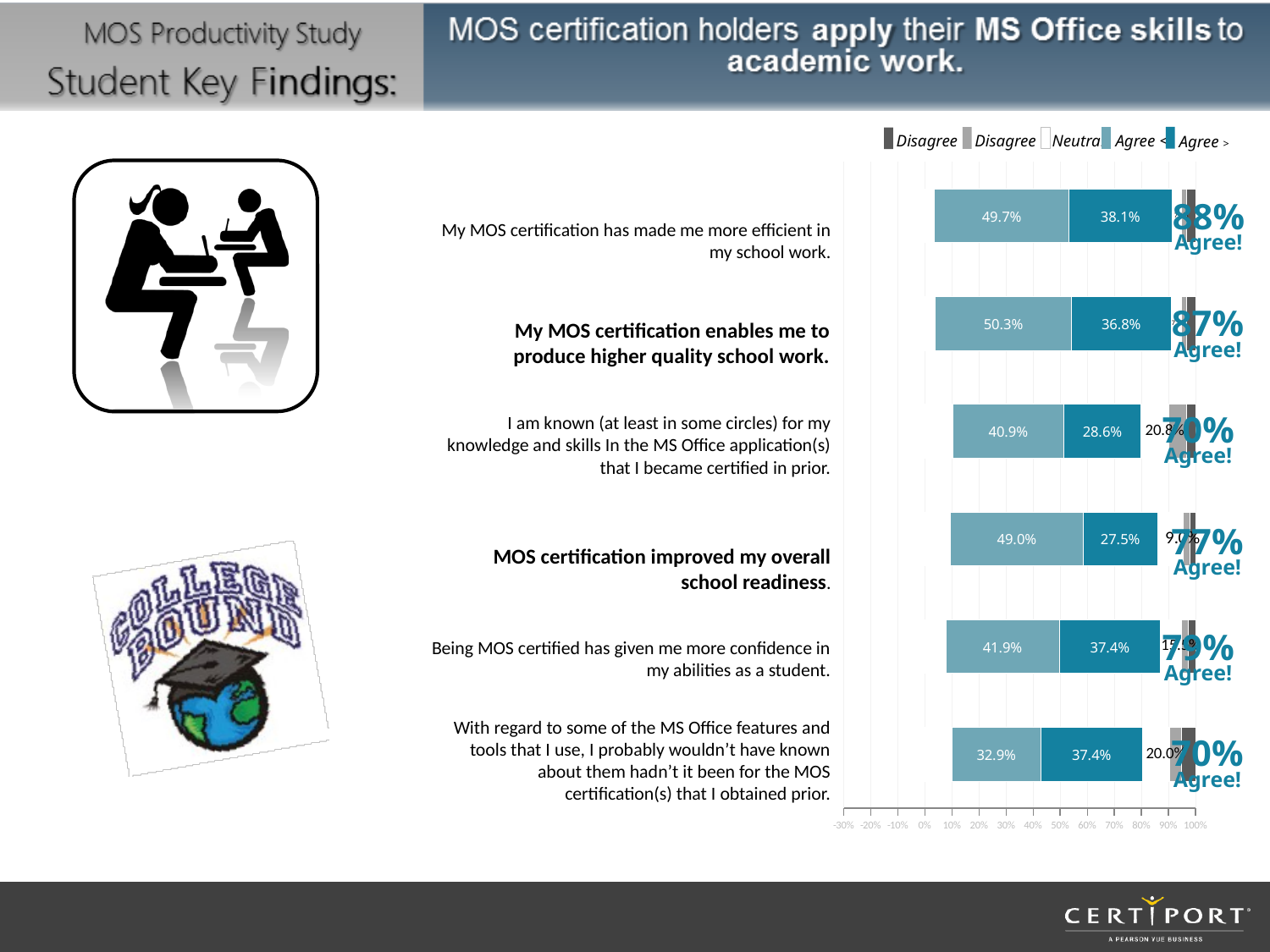
How many statements (categories) are plotted in the chart? 6 What overall agreement percentage is printed next to the bar for 'MOS certification improved my overall school readiness'? 77% What neutral value is labelled for 'I am known (at least in some circles) for my knowledge and skills in the MS Office application(s) that I became certified in prior'? 20.8% What overall agreement percentage is printed next to the bar for 'Being MOS certified has given me more confidence in my abilities as a student'? 79% How many series does the chart legend list? 5 For 'My MOS certification has made me more efficient in my school work', what is the difference between the lighter teal segment (49.7%) and the darker teal segment (38.1%)? 11.6 percentage points Which statement has the lowest value in the lighter teal segment? With regard to some of the MS Office features and tools that I use, I probably wouldn't have known about them hadn't it been for the MOS certification(s) that I obtained prior. Which statement has the highest value in the lighter teal segment? My MOS certification enables me to produce higher quality school work. What type of chart is shown on the slide? Stacked horizontal bar chart What is the value of the darker teal segment for 'My MOS certification enables me to produce higher quality school work'? 36.8% What is the value of the lighter teal segment for 'My MOS certification has made me more efficient in my school work'? 49.7% Which is larger: the darker teal segment for 'MOS certification improved my overall school readiness' or the darker teal segment for 'Being MOS certified has given me more confidence in my abilities as a student'? Being MOS certified has given me more confidence in my abilities as a student (37.4%)